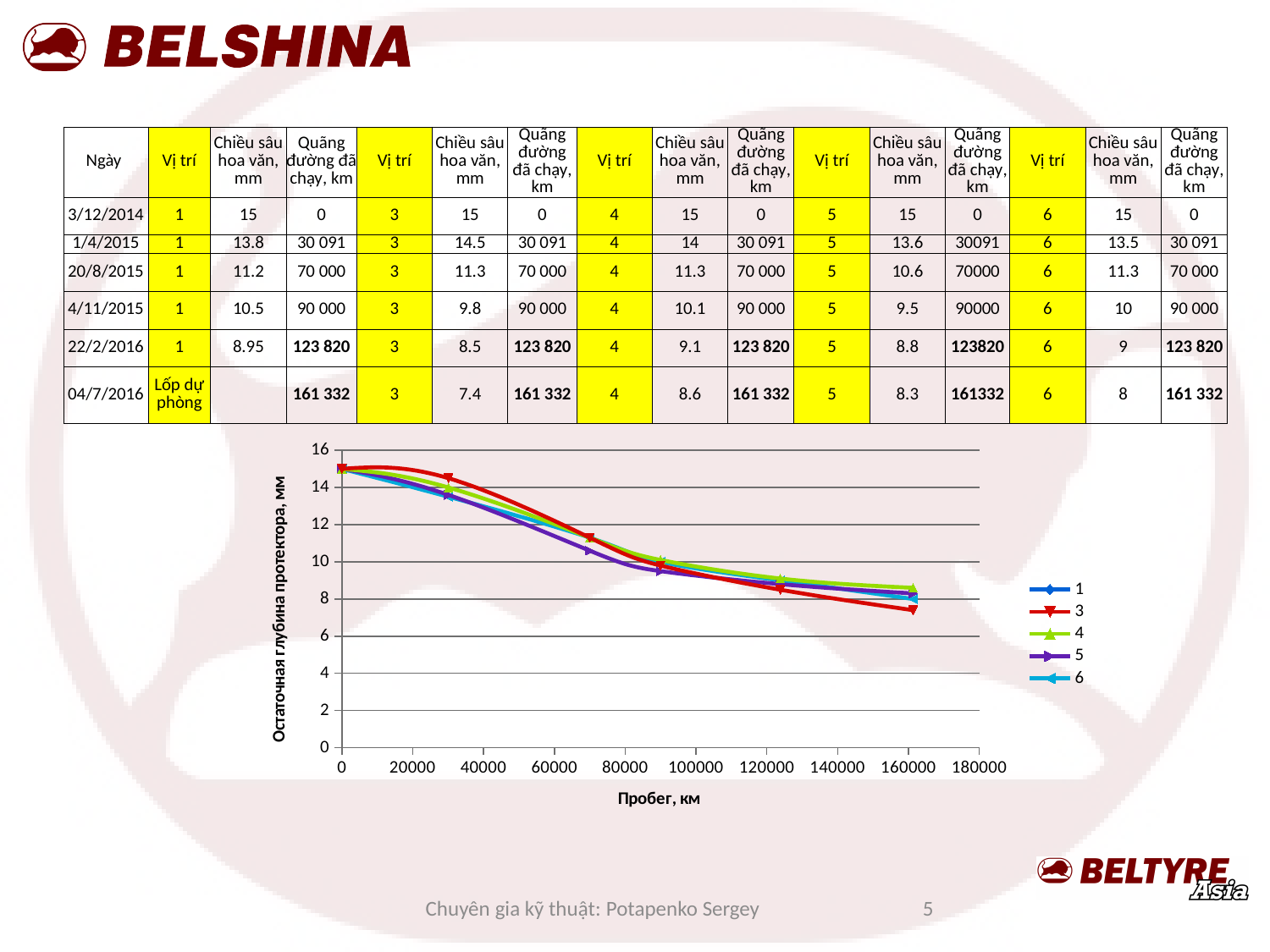
Which series are listed in the chart legend? 1, 3, 4, 5, 6 What is the title of the chart's x axis? Пробег, км Which series has the lowest value at the right end of the chart (around 160000 km)? 3 Is the value for series 4 at the final mileage point greater or less than 8? greater Do the plotted values rise or fall as mileage increases along the x axis? fall According to the table, what is the tread depth for position 3 at 161 332 km? 7.4 How many series does the chart legend list? 5 What type of chart is shown on the slide? line chart Are the values of all series at 0 km greater or less than 14? greater Is the value for series 3 at the final mileage point greater or less than 8? less According to the table, what is the difference between the tread depth of position 4 and position 3 at 161 332 km? 1.2 At the final mileage point, which is larger: the value for series 4 or the value for series 3? series 4